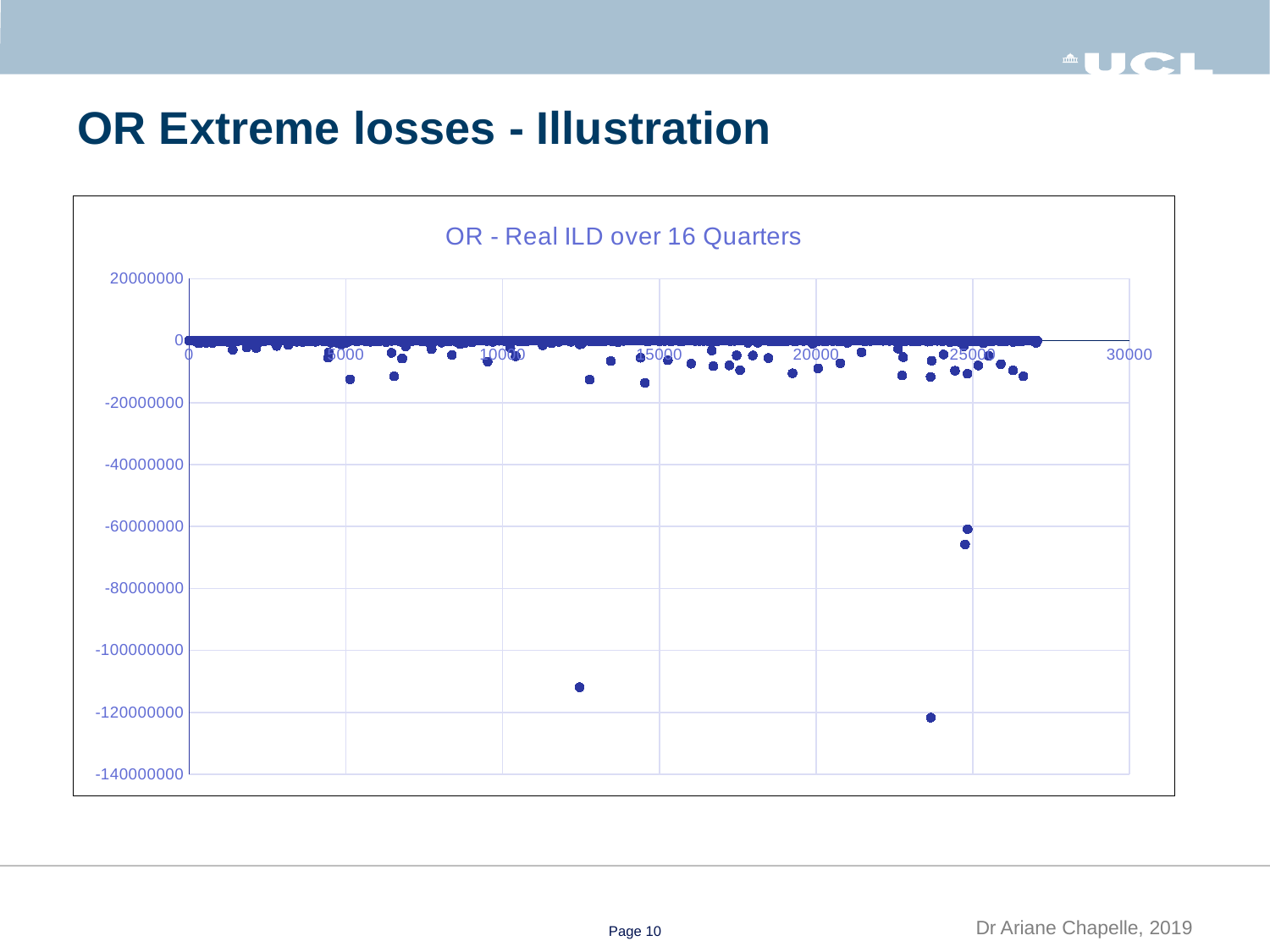
Is the lowest point plotted near x = 12500 greater or less than -100000000? less Which is lower: the lowest point near x = 12500 or the lowest point near x = 24000? the point near x = 24000 Is the lowest plotted value on the chart greater or less than -100000000? less What kind of chart is shown on the slide? scatter chart What is the title of the chart? OR - Real ILD over 16 Quarters Are the vast majority of the plotted points greater or less than -20000000? greater What is the lowest value shown on the y axis? -140000000